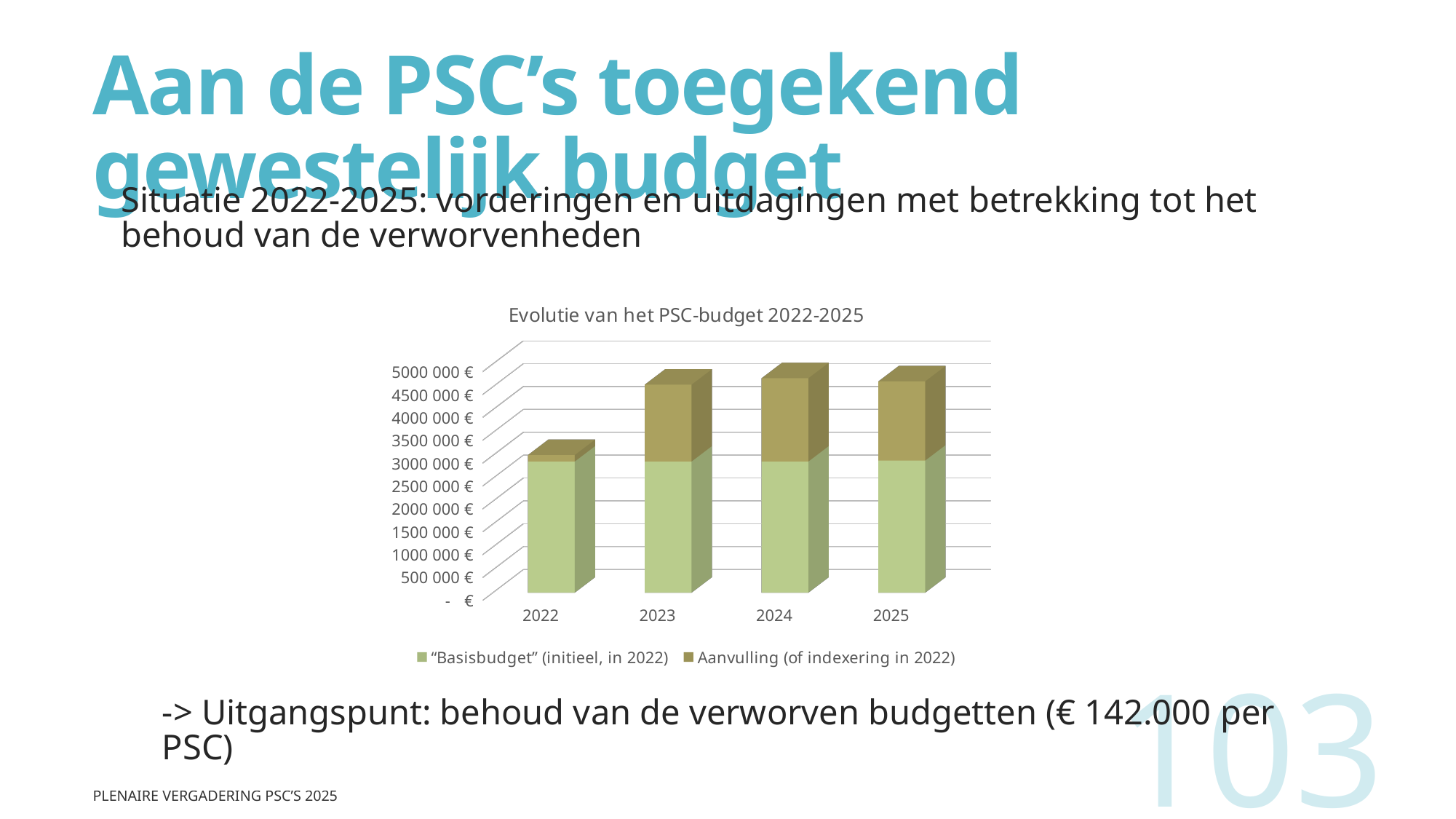
What is the title of the chart? Evolutie van het PSC-budget 2022-2025 Which year has the lowest total budget in the chart? 2022 What kind of chart is shown on the slide? bar chart Is the "Basisbudget" value for 2022 greater or less than 3500 000 €? less Is the total budget for 2023 greater or less than 4000 000 €? greater Is the total budget for 2022 greater or less than 4000 000 €? less Does the total budget rise or fall from 2022 to 2023? rise Which series is shown in the darker colour at the top of each stacked bar? Aanvulling (of indexering in 2022) How many years are shown on the x axis of the chart? 4 How many series does the chart's legend list? 2 Which year has the larger total budget, 2022 or 2023? 2023